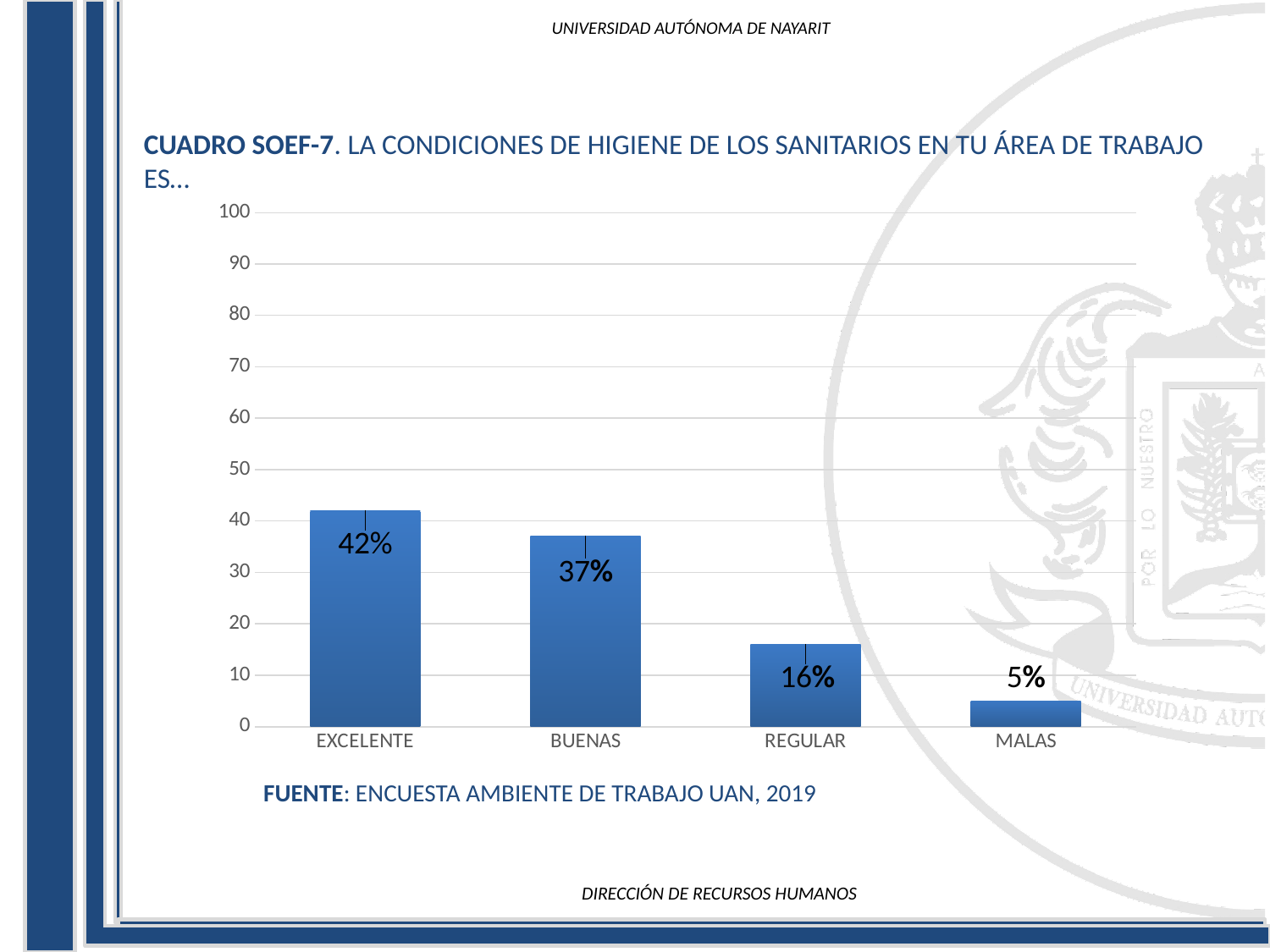
What is the value for BUENAS? 37% Which category has the highest value? EXCELENTE Is the value for BUENAS greater or less than 30? greater Which is larger, the value for REGULAR or the value for MALAS? REGULAR What kind of chart is shown on the slide? Bar chart What is the value for EXCELENTE? 42% How many categories are shown on the x axis? 4 Do the values rise or fall from left to right along the x axis? Fall What is the value for REGULAR? 16% What is the value for MALAS? 5% Which category has the lowest value? MALAS What is the difference between the values for EXCELENTE and BUENAS? 5%